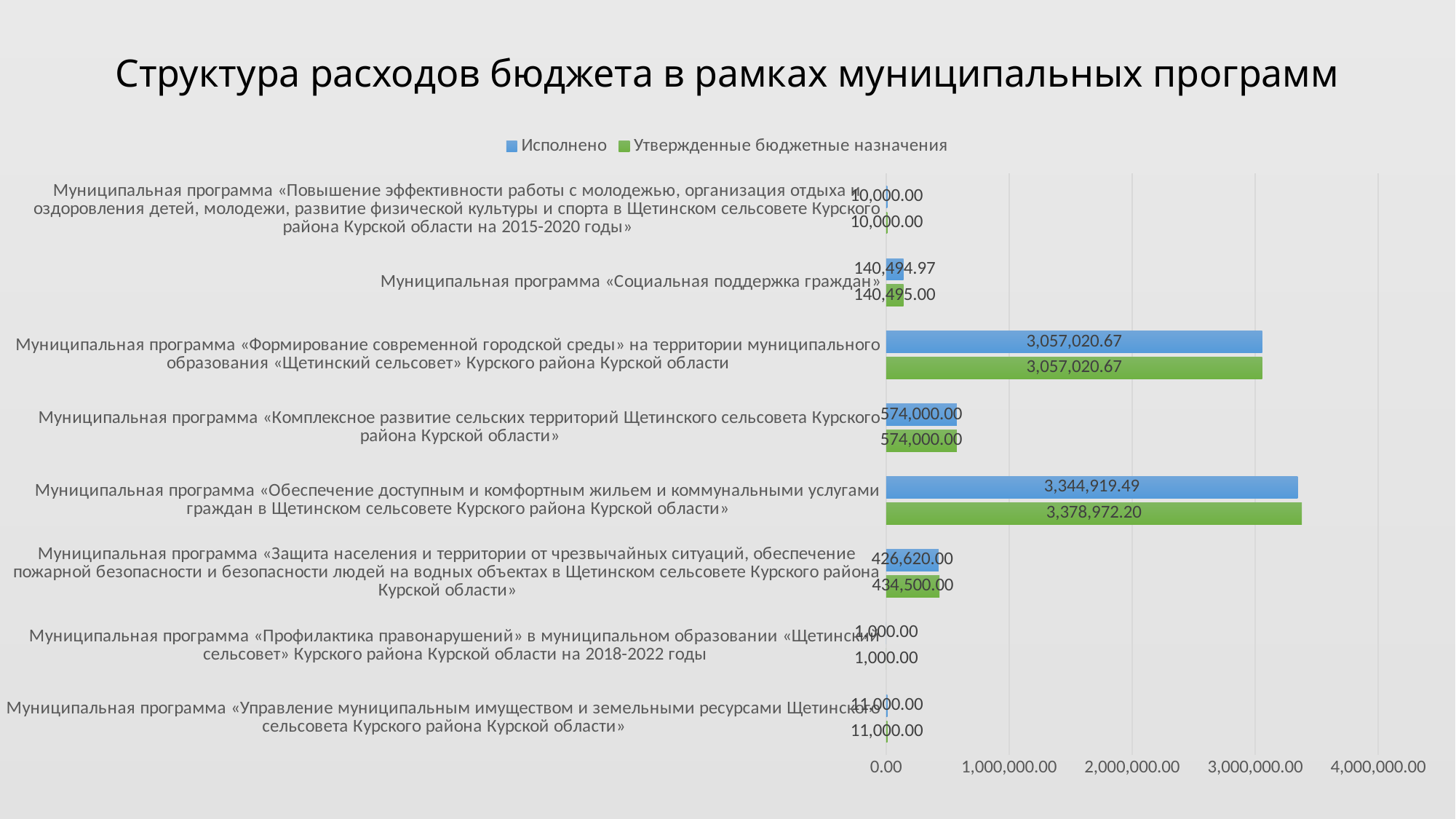
What is the Исполнено value for the program «Защита населения и территории от чрезвычайных ситуаций...»? 426,620.00 Which is larger: the Исполнено value for «Формирование современной городской среды...» or the Исполнено value for «Комплексное развитие сельских территорий...»? «Формирование современной городской среды...» What type of chart is shown on the slide? bar chart What is the title of the chart? Структура расходов бюджета в рамках муниципальных программ How many municipal programs (categories) are shown in the chart? 8 Which program has the lowest Утвержденные бюджетные назначения value? Муниципальная программа «Профилактика правонарушений» в муниципальном образовании «Щетинский сельсовет» Курского района Курской области на 2018-2022 годы What is the Исполнено value for the program «Социальная поддержка граждан»? 140,494.97 Which program has the highest Исполнено value? Муниципальная программа «Обеспечение доступным и комфортным жильем и коммунальными услугами граждан в Щетинском сельсовете Курского района Курской области» What is the difference between the Утвержденные бюджетные назначения and Исполнено values for the program «Защита населения и территории от чрезвычайных ситуаций...»? 7,880.00 What is the difference between the Утвержденные бюджетные назначения and Исполнено values for the program «Обеспечение доступным и комфортным жильем...»? 34,052.71 How many series does the legend list? 2 What is the Утвержденные бюджетные назначения value for the program «Обеспечение доступным и комфортным жильем и коммунальными услугами граждан в Щетинском сельсовете Курского района Курской области»? 3,378,972.20